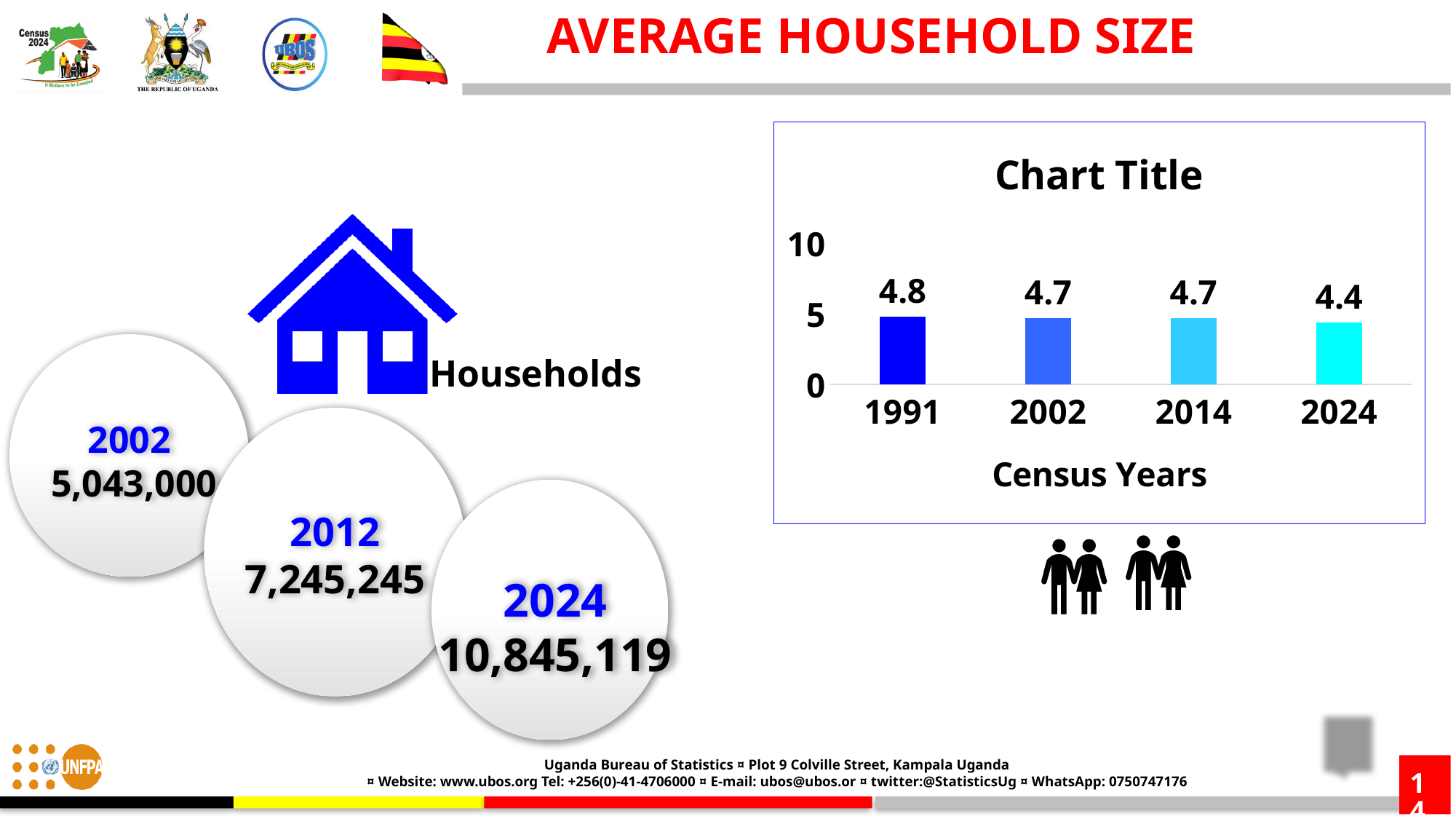
What is the average household size shown for 1991? 4.8 Which census year has the highest average household size? 1991 What kind of chart is shown on the slide? bar chart Do the values rise or fall from 1991 to 2024? fall Which is larger, the value for 2002 or the value for 2024? 2002 Is the value for 1991 greater or less than 5? less Which census year has the lowest average household size? 2024 How many census years are plotted in the chart? 4 What is the label on the x axis of the chart? Census Years What value does the bar for 2014 show? 4.7 What is the difference between the average household size in 1991 and in 2024? 0.4 What is the average household size shown for 2024? 4.4